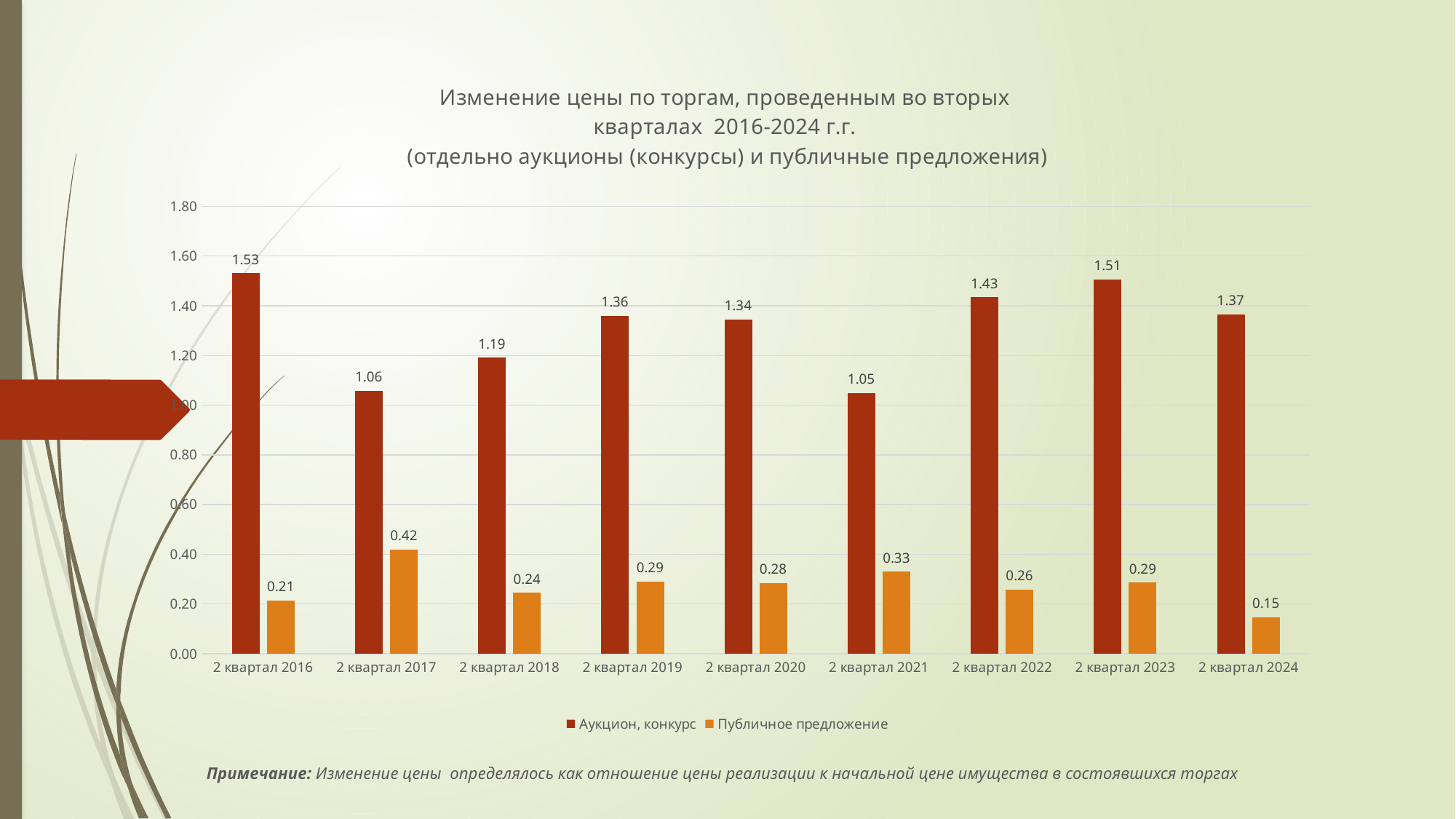
What is the value for "Публичное предложение" in 2 квартал 2017? 0.42 Which quarter has the lowest value for "Публичное предложение"? 2 квартал 2024 Which is larger: the "Аукцион, конкурс" value in 2 квартал 2019 or in 2 квартал 2020? 2 квартал 2019 What is the value for "Публичное предложение" in 2 квартал 2024? 0.15 How many series does the legend list? 2 What is the difference between the "Аукцион, конкурс" value and the "Публичное предложение" value in 2 квартал 2022? 1.17 Which series is shown in orange in the legend? Публичное предложение Which quarter has the highest value for "Аукцион, конкурс"? 2 квартал 2016 What kind of chart is shown on the slide? Bar chart What is the value for "Аукцион, конкурс" in 2 квартал 2016? 1.53 How many quarters are shown on the x axis? 9 What is the value for "Аукцион, конкурс" in 2 квартал 2021? 1.05